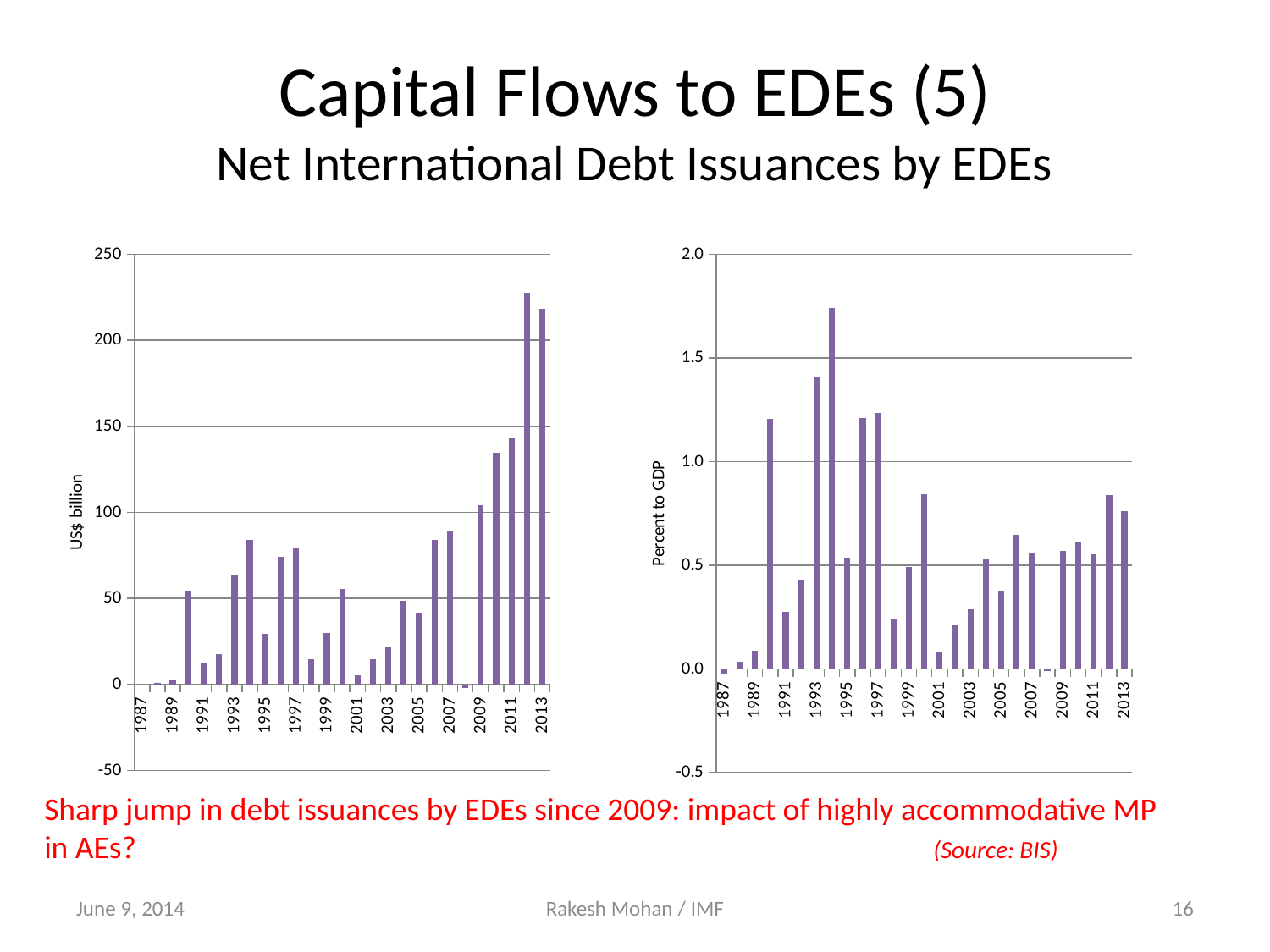
In the left chart (US$ billion), is the value for 2012 greater or less than 200? greater In the right chart (Percent to GDP), which year has the highest value? 1994 What kind of chart is the right chart (Percent to GDP)? bar chart In the left chart (US$ billion), do the values rise or fall from 2009 to 2012? rise In the left chart (US$ billion), which is larger, the value for 2011 or the value for 2005? 2011 What is the y-axis label of the right chart? Percent to GDP In the left chart (US$ billion), how many years are plotted along the x axis? 27 In the left chart (US$ billion), is the value for 2010 greater or less than 100? greater In the right chart (Percent to GDP), is the value for 2013 greater or less than 0.5? greater What kind of chart is the left chart (US$ billion)? bar chart